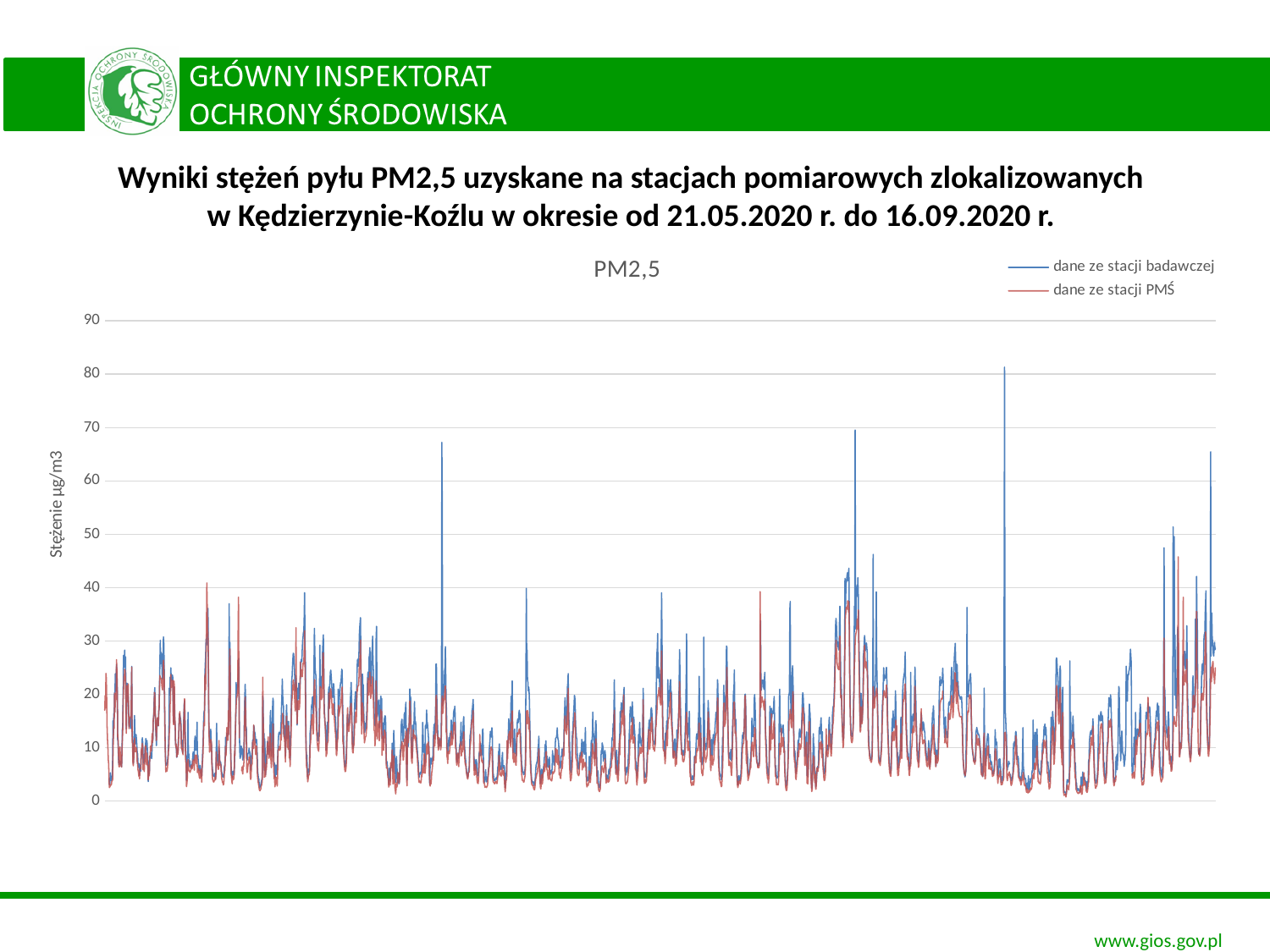
What is the title of the chart? PM2,5 Is the highest value of the 'dane ze stacji badawczej' series greater or less than 70? greater Which series has the higher maximum value: 'dane ze stacji badawczej' or 'dane ze stacji PMŚ'? dane ze stacji badawczej What kind of chart is shown on the slide? line chart Is the highest value of the 'dane ze stacji PMŚ' series greater or less than 30? greater What label is shown on the vertical axis of the chart? Stężenie µg/m3 What is the highest tick value shown on the vertical axis? 90 Which series reaches the highest peak on the chart? dane ze stacji badawczej How many series does the legend of the PM2,5 chart list? 2